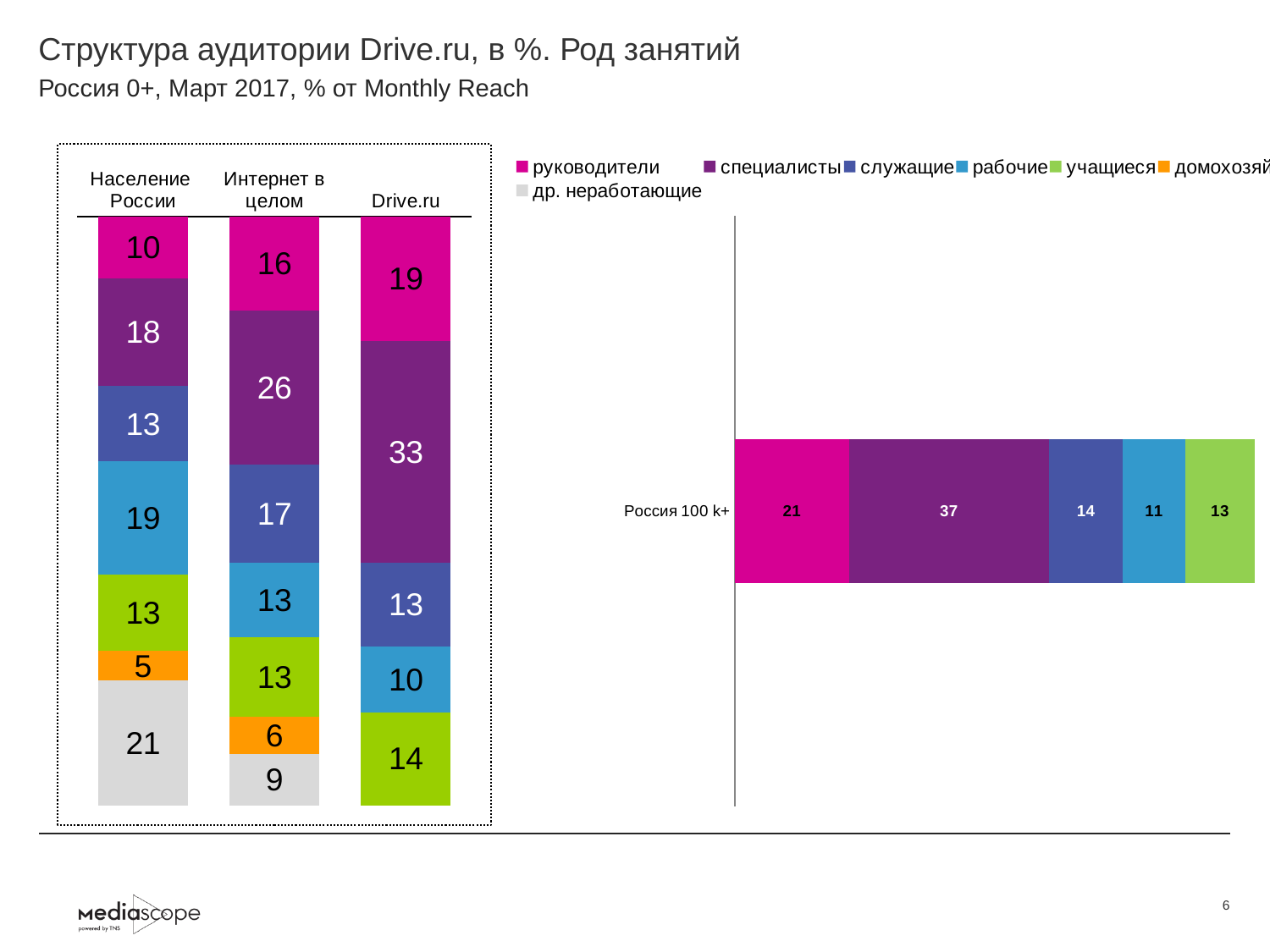
In the right chart, what is the value for специалисты in the Россия 100 k+ bar? 37 How many bars (categories) are shown in the left chart? 3 In the left chart, which of the three bars has the highest value for специалисты? Drive.ru In the left chart, what is the value for др. неработающие in the Интернет в целом bar? 9 In the left chart, what is the difference between the специалисты values for Drive.ru and Население России? 15 How many series does the legend list? 7 In the left chart, what is the value for специалисты in the Drive.ru bar? 33 In the left chart, is the рабочие value larger for Население России or for Drive.ru? Население России In the left chart, what is the value for руководители in the Население России bar? 10 In the left chart, which of the three bars has the lowest value for др. неработающие? Интернет в целом What kind of chart is the right chart (Россия 100 k+)? Stacked bar chart